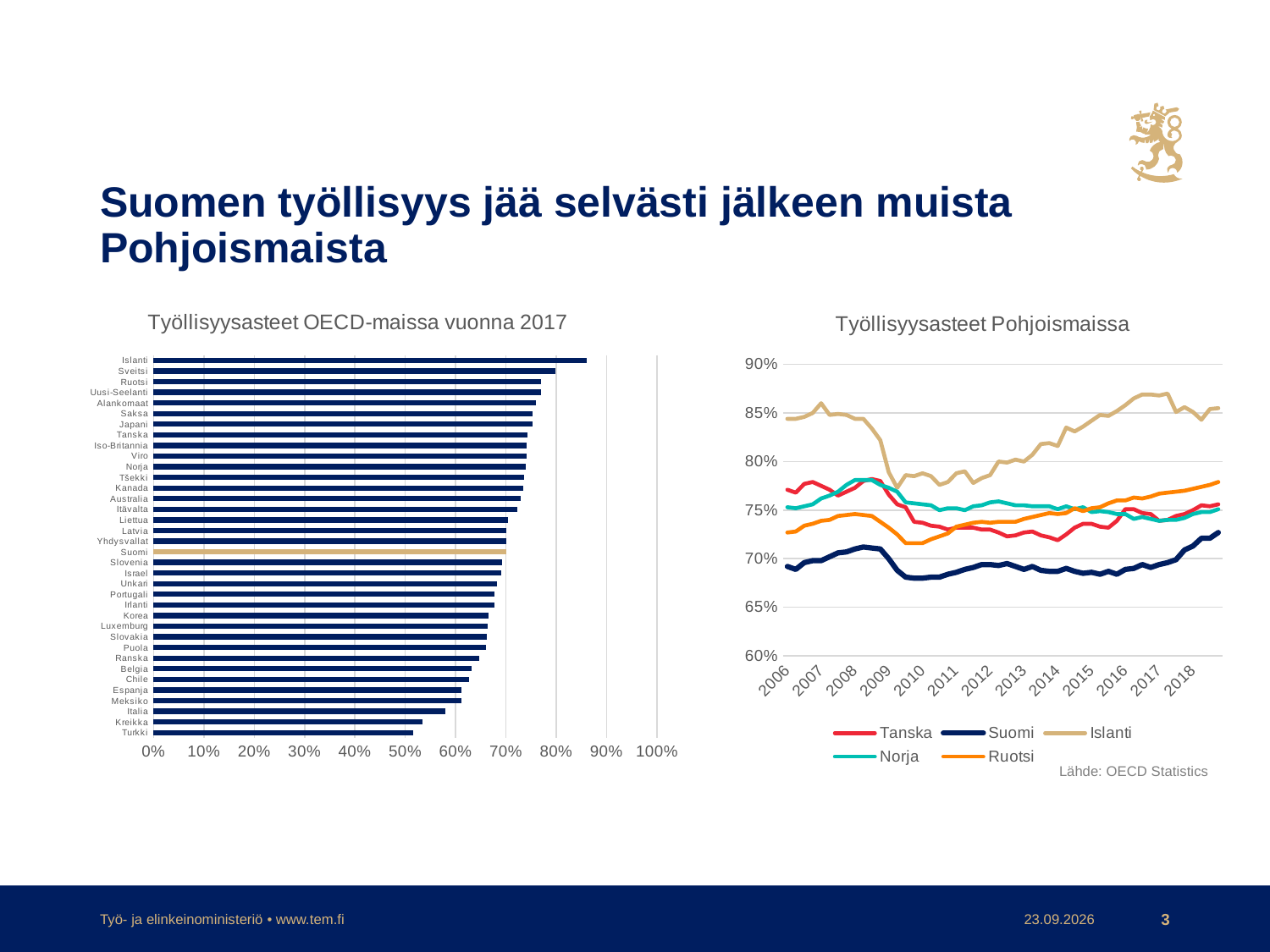
In the chart 'Työllisyysasteet OECD-maissa vuonna 2017', which country has the highest employment rate? Islanti In the chart 'Työllisyysasteet Pohjoismaissa', is the value for Suomi in 2010 greater or less than 70%? less In the chart 'Työllisyysasteet OECD-maissa vuonna 2017', which country's bar is highlighted in a different (gold) colour? Suomi In the chart 'Työllisyysasteet OECD-maissa vuonna 2017', is the value for Kreikka greater or less than 60%? less What kind of chart is 'Työllisyysasteet Pohjoismaissa'? line chart In the chart 'Työllisyysasteet OECD-maissa vuonna 2017', which country has the lowest employment rate? Turkki In the chart 'Työllisyysasteet OECD-maissa vuonna 2017', is the value for Islanti greater or less than 80%? greater What kind of chart is 'Työllisyysasteet OECD-maissa vuonna 2017'? bar chart How many series does the legend of the chart 'Työllisyysasteet Pohjoismaissa' list? 5 In the chart 'Työllisyysasteet Pohjoismaissa', which series has the lowest values throughout the period? Suomi In the chart 'Työllisyysasteet OECD-maissa vuonna 2017', which has the larger value, Ruotsi or Suomi? Ruotsi